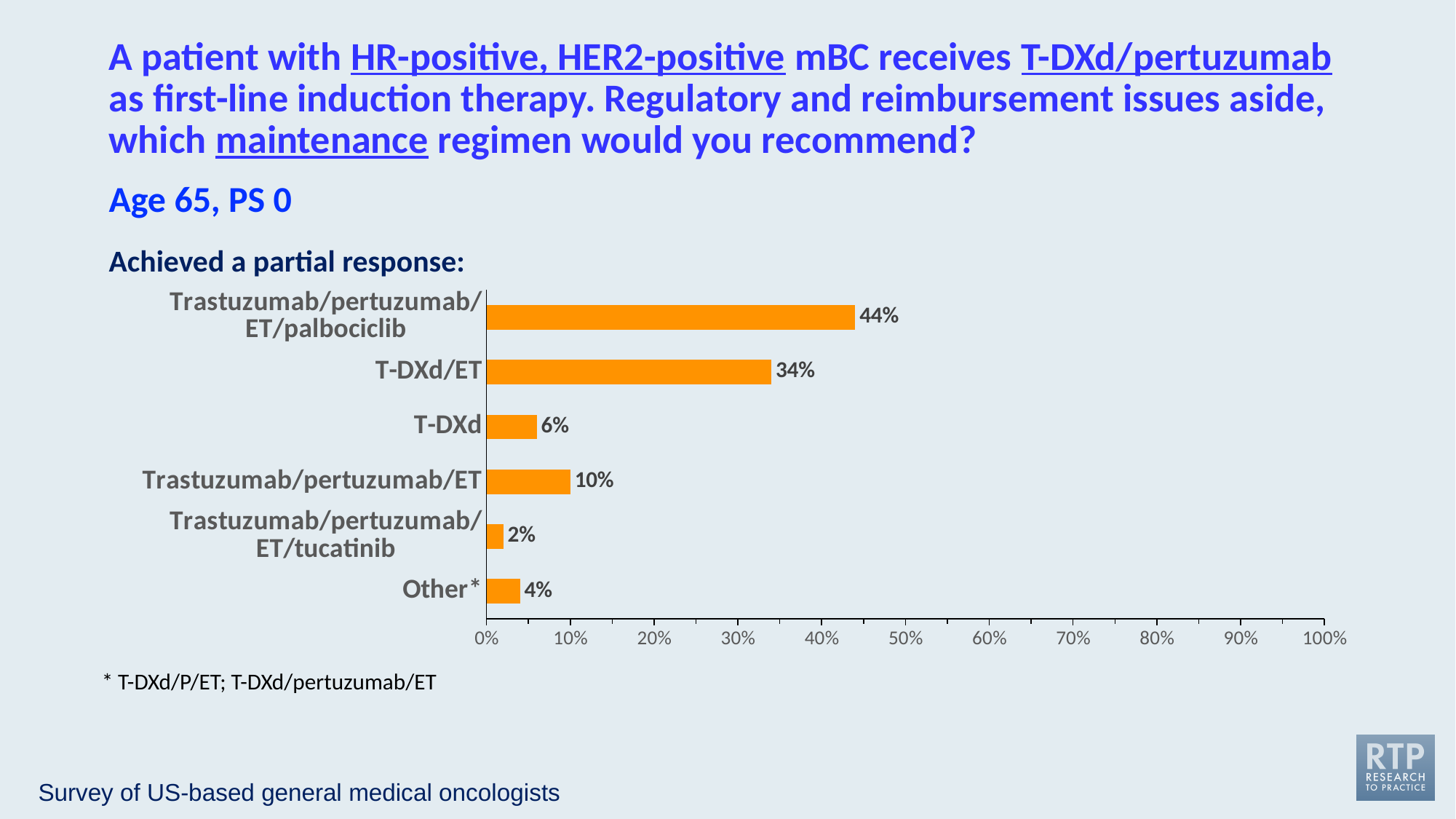
What does the asterisk on 'Other' refer to, according to the footnote? T-DXd/P/ET; T-DXd/pertuzumab/ET Is the value for T-DXd/ET greater or less than 30%? greater What is the difference in percentage points between trastuzumab/pertuzumab/ET/palbociclib and T-DXd/ET? 10 Which maintenance regimen received the lowest percentage of recommendations? Trastuzumab/pertuzumab/ET/tucatinib What type of chart is used on this slide? Bar chart What percentage of respondents recommended T-DXd/ET as the maintenance regimen? 34% What percentage of respondents recommended trastuzumab/pertuzumab/ET/tucatinib? 2% What is the combined percentage for T-DXd/ET and T-DXd alone? 40% Which maintenance regimen received the highest percentage of recommendations? Trastuzumab/pertuzumab/ET/palbociclib Which received a higher percentage: T-DXd alone or trastuzumab/pertuzumab/ET? Trastuzumab/pertuzumab/ET How many maintenance regimen categories are shown in the chart? 6 What percentage of respondents recommended trastuzumab/pertuzumab/ET/palbociclib? 44%